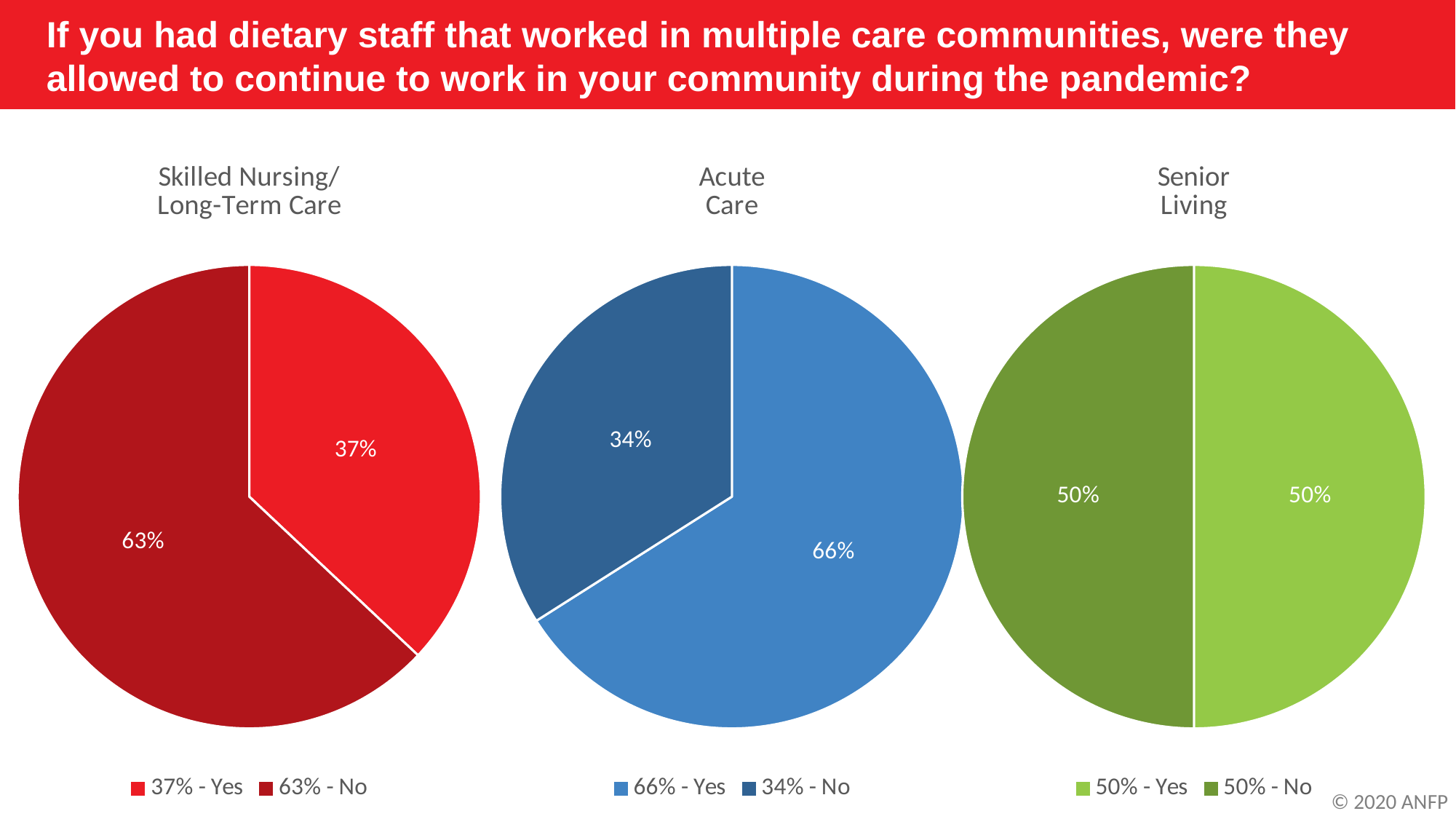
How many pie charts are on the slide? 3 In the Acute Care pie chart, which response has the smaller share? No In the Skilled Nursing/Long-Term Care pie chart, which response has the larger share? No In the Acute Care pie chart, what percentage answered Yes? 66% In the Skilled Nursing/Long-Term Care pie chart, what percentage answered No? 63% In the Skilled Nursing/Long-Term Care pie chart, what percentage answered Yes? 37% What kind of charts are shown on the slide? pie charts Is the Yes share in the Acute Care pie chart larger or smaller than the Yes share in the Skilled Nursing/Long-Term Care pie chart? larger In the Acute Care pie chart, what percentage answered No? 34% In the Skilled Nursing/Long-Term Care pie chart, what is the difference between the No and Yes percentages? 26% In the Acute Care pie chart, what is the difference between the Yes and No percentages? 32% In the Senior Living pie chart, what percentage answered Yes? 50%